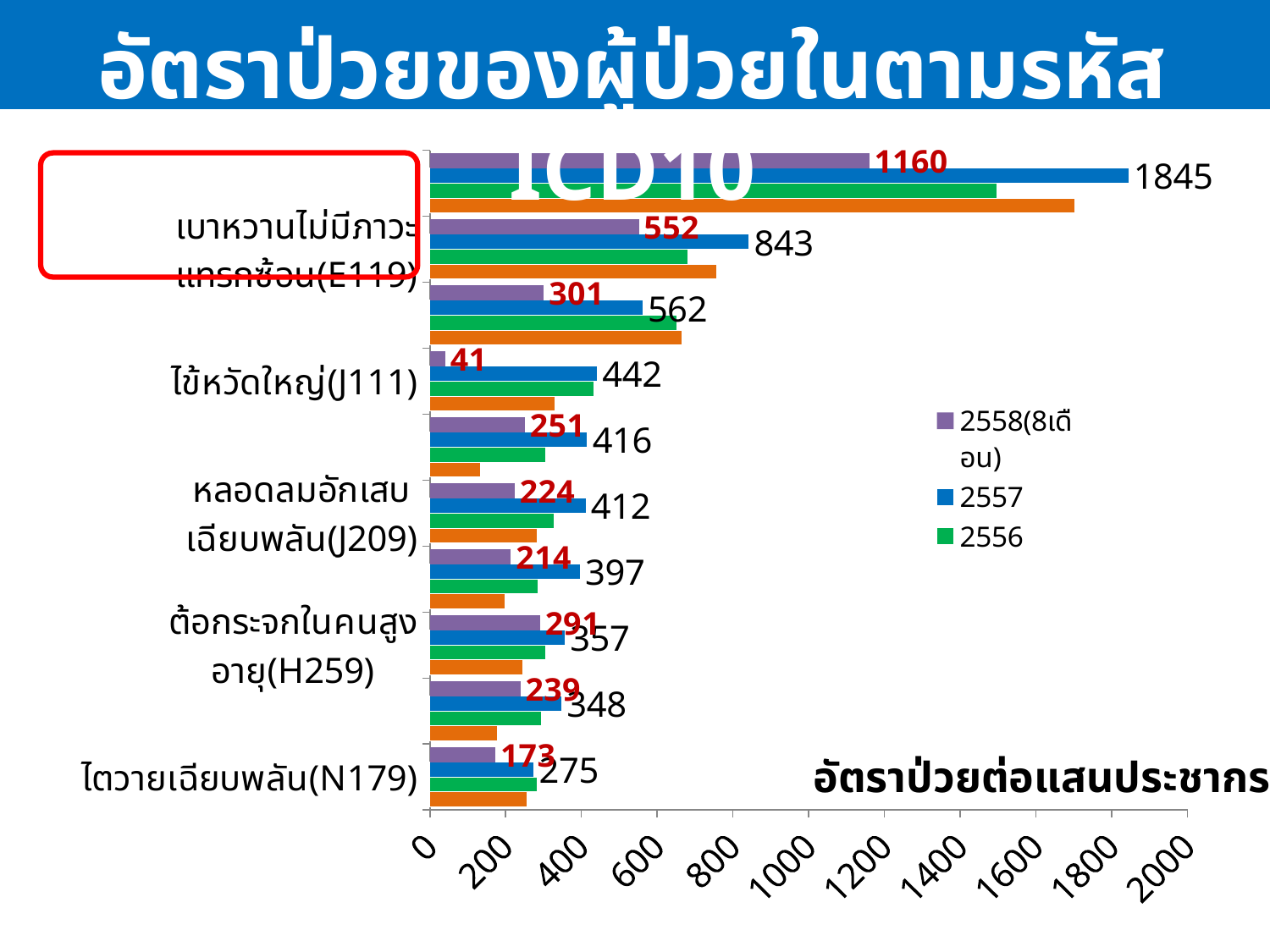
Which labelled category has the lowest 2558(8เดือน) value? ไข้หวัดใหญ่(J111) What is the highest 2557 value shown on the chart? 1845 What is the difference between the 2557 and 2558(8เดือน) values for เบาหวานไม่มีภาวะแทรกซ้อน(E119)? 291 Is the 2556 value for เบาหวานไม่มีภาวะแทรกซ้อน(E119) greater or less than 600? greater What is the 2558(8เดือน) value for เบาหวานไม่มีภาวะแทรกซ้อน(E119)? 552 What is the 2557 value for หลอดลมอักเสบเฉียบพลัน(J209)? 412 What kind of chart is shown on the slide? bar chart What is the 2557 value for เบาหวานไม่มีภาวะแทรกซ้อน(E119)? 843 What is the 2557 value for ไตวายเฉียบพลัน(N179)? 275 What is the 2558(8เดือน) value for ไข้หวัดใหญ่(J111)? 41 How many series does the legend list? 3 For ต้อกระจกในคนสูงอายุ(H259), which is larger: the 2557 value or the 2558(8เดือน) value? 2557